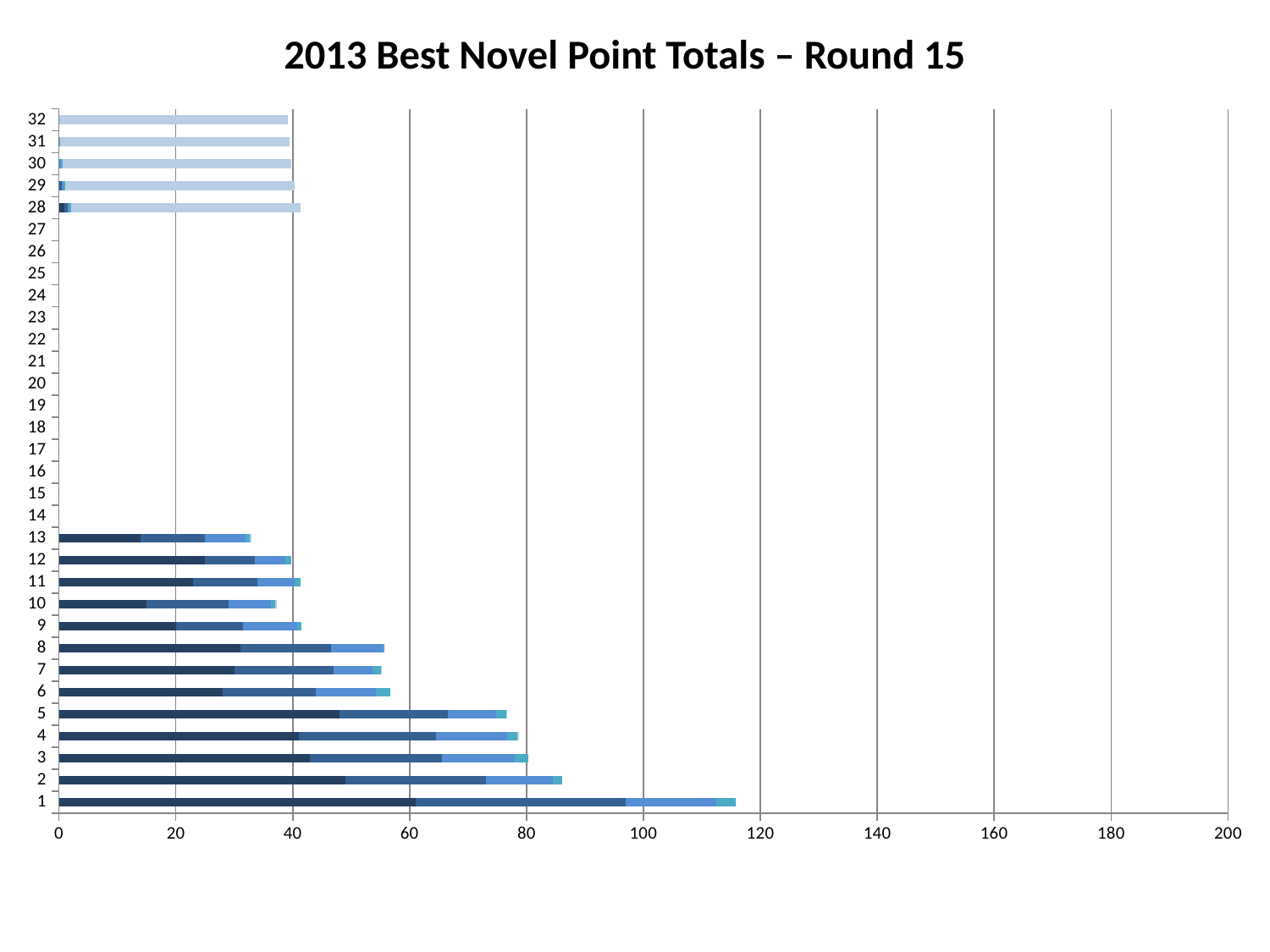
Is the total value for category 13 greater or less than 40? less Which has the larger total, category 1 or category 2? 1 Is the total value for category 5 greater or less than 80? less What is the title of the chart? 2013 Best Novel Point Totals – Round 15 Is the total value for category 8 greater or less than 60? less What kind of chart is shown on the slide? Bar chart What is the highest value shown on the horizontal axis of the chart? 200 Which has the larger total, category 8 or category 13? 8 Which category has the longest bar in the chart? 1 How many categories are listed on the vertical axis of the chart? 32